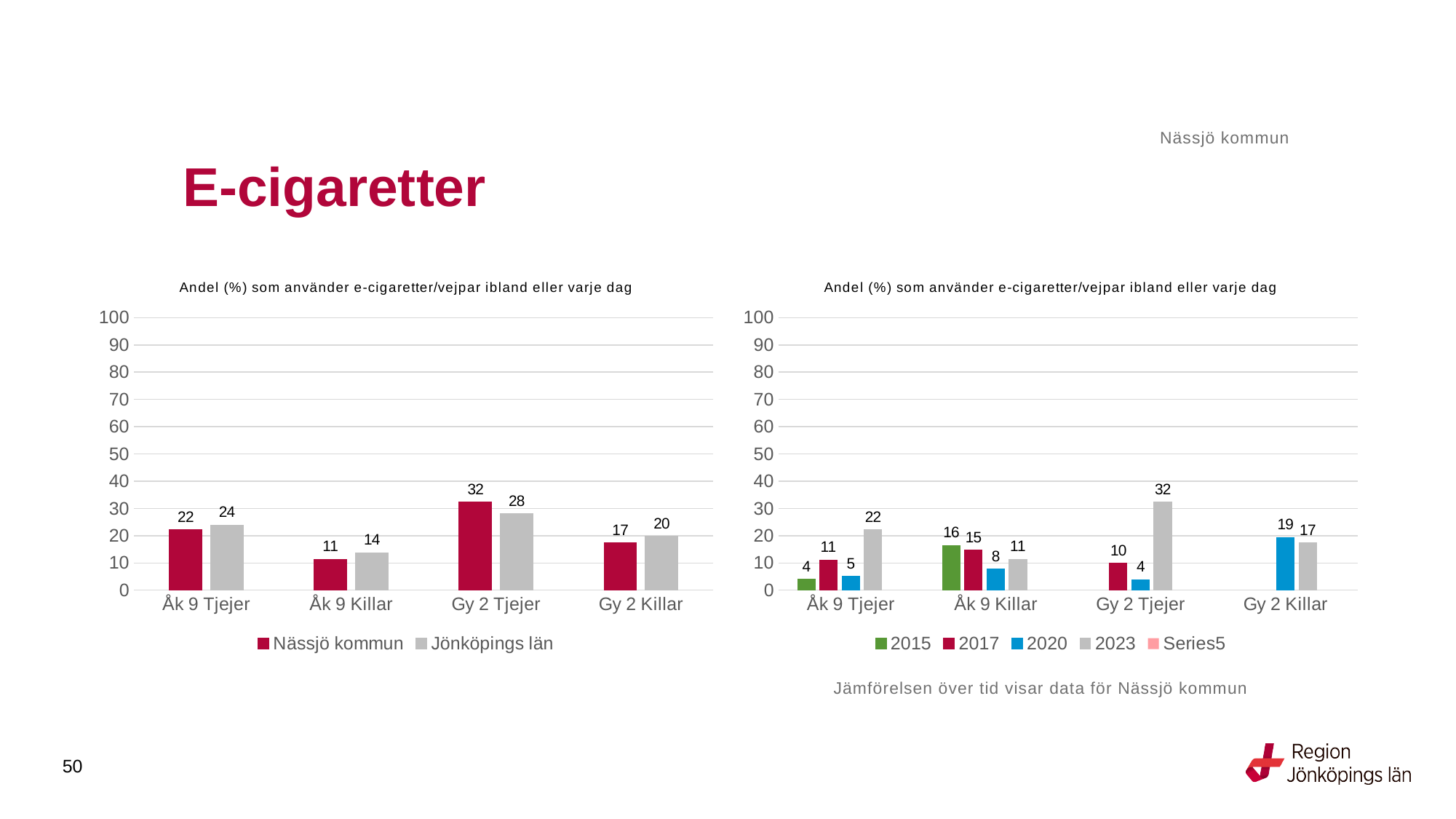
How many series does the legend of the right chart list? 5 In the right chart, what is the value for 2015 for Åk 9 Killar? 16 What kind of chart is the left chart? Bar chart In the right chart, what is the difference between the 2023 and 2020 values for Åk 9 Tjejer? 17 In the right chart, what is the value for 2023 for Gy 2 Tjejer? 32 In the left chart, what is the difference between Jönköpings län and Nässjö kommun for Gy 2 Killar? 3 In the left chart, what is the value for Jönköpings län for Åk 9 Killar? 14 In the right chart, which category has the lowest value for 2020? Gy 2 Tjejer In the left chart, which is larger for Gy 2 Tjejer: Nässjö kommun or Jönköpings län? Nässjö kommun How many categories are shown on the x axis of the left chart? 4 In the left chart, which category has the highest value for Nässjö kommun? Gy 2 Tjejer In the left chart, what is the value for Nässjö kommun for Gy 2 Tjejer? 32